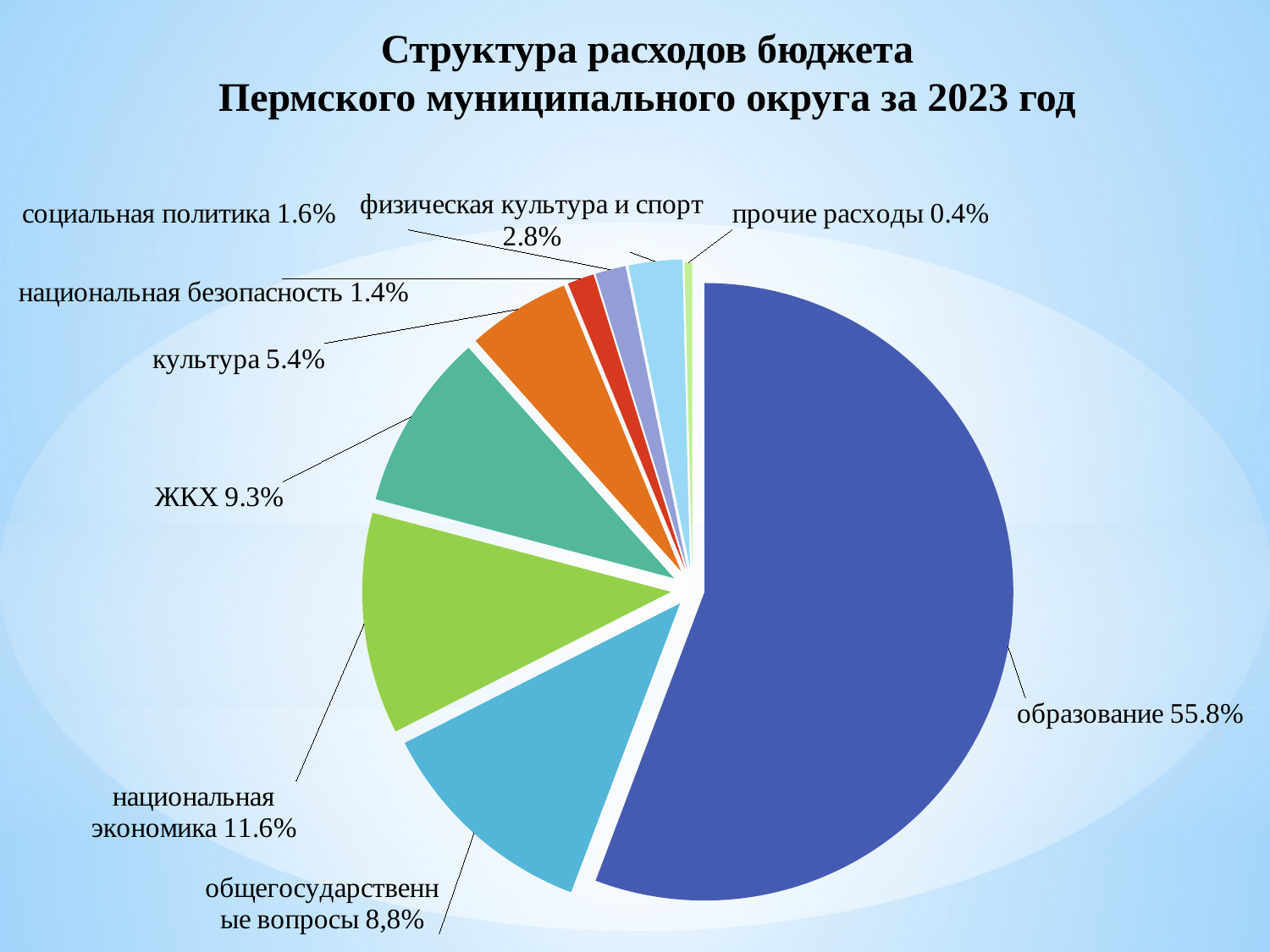
What kind of chart is shown on the slide? pie chart What share of budget expenditures goes to прочие расходы? 0.4% What share of budget expenditures goes to национальная экономика? 11.6% What is the title of the chart? Структура расходов бюджета Пермского муниципального округа за 2023 год Which category has the smallest share of budget expenditures? прочие расходы What is the difference in percentage points between образование and национальная экономика? 44.2 What share of budget expenditures goes to образование? 55.8% What share of budget expenditures goes to ЖКХ? 9.3% What share of budget expenditures goes to культура? 5.4% How many categories (slices) does the pie chart show? 9 Which category has the largest share of budget expenditures? образование Which is larger: the share for ЖКХ or the share for культура? ЖКХ